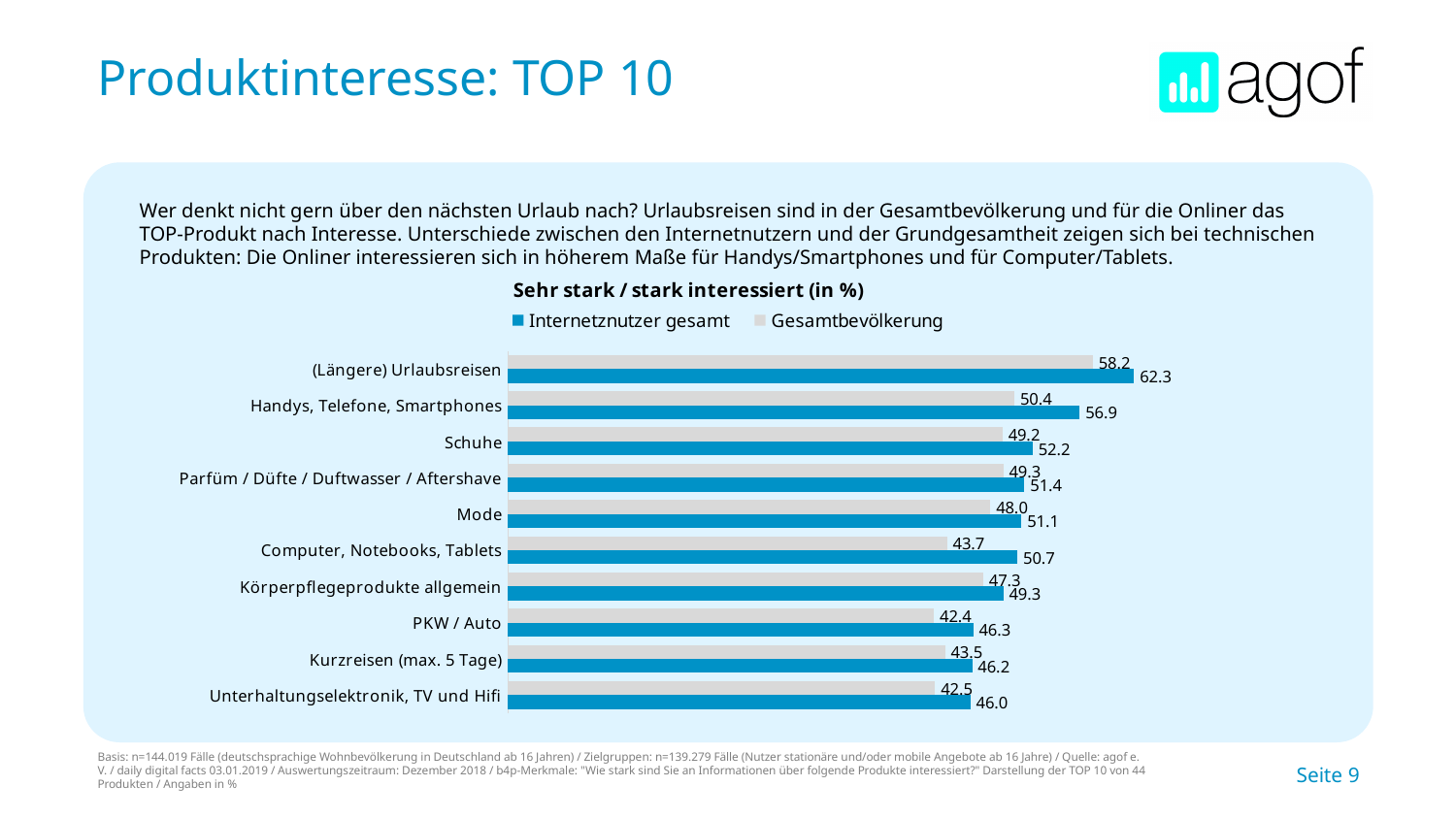
Which is larger for Computer, Notebooks, Tablets: the Internetnutzer gesamt value or the Gesamtbevölkerung value? Internetnutzer gesamt What is the value for Internetnutzer gesamt for PKW / Auto? 46.3 How many product categories are shown in the chart? 10 What kind of chart is shown on the slide? Bar chart What is the value for Internetnutzer gesamt for (Längere) Urlaubsreisen? 62.3 What is the title of the chart? Sehr stark / stark interessiert (in %) Which colour represents Gesamtbevölkerung in the chart? Grey How many series does the legend list? 2 Which category has the lowest value for Gesamtbevölkerung? PKW / Auto What is the value for Gesamtbevölkerung for Computer, Notebooks, Tablets? 43.7 What is the difference between the Internetnutzer gesamt and Gesamtbevölkerung values for Handys, Telefone, Smartphones? 6.5 Which category has the highest value for Internetnutzer gesamt? (Längere) Urlaubsreisen